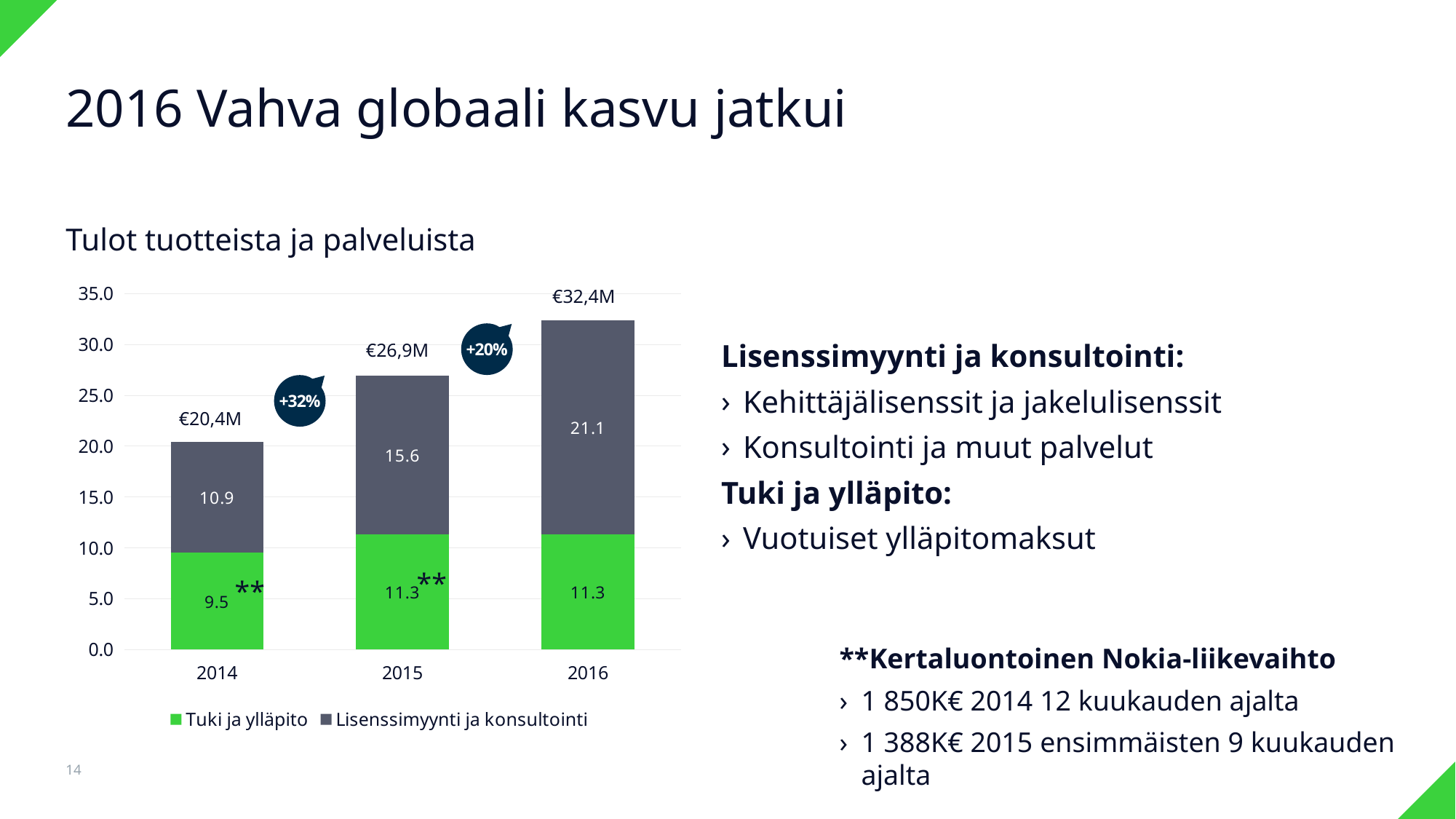
Which is larger in 2015: Tuki ja ylläpito or Lisenssimyynti ja konsultointi? Lisenssimyynti ja konsultointi What is the difference between the Lisenssimyynti ja konsultointi values for 2016 and 2015? 5.5 What is the total revenue shown above the 2014 bar? €20,4M How many years are shown on the x axis? 3 What is the value for Lisenssimyynti ja konsultointi in 2016? 21.1 How many series does the legend list? 2 Which year has the highest value for Lisenssimyynti ja konsultointi? 2016 What kind of chart is shown on the slide? Stacked bar chart Which year has the lowest value for Tuki ja ylläpito? 2014 What is the total revenue shown above the 2016 bar? €32,4M What is the value for Lisenssimyynti ja konsultointi in 2015? 15.6 What is the value for Tuki ja ylläpito in 2014? 9.5